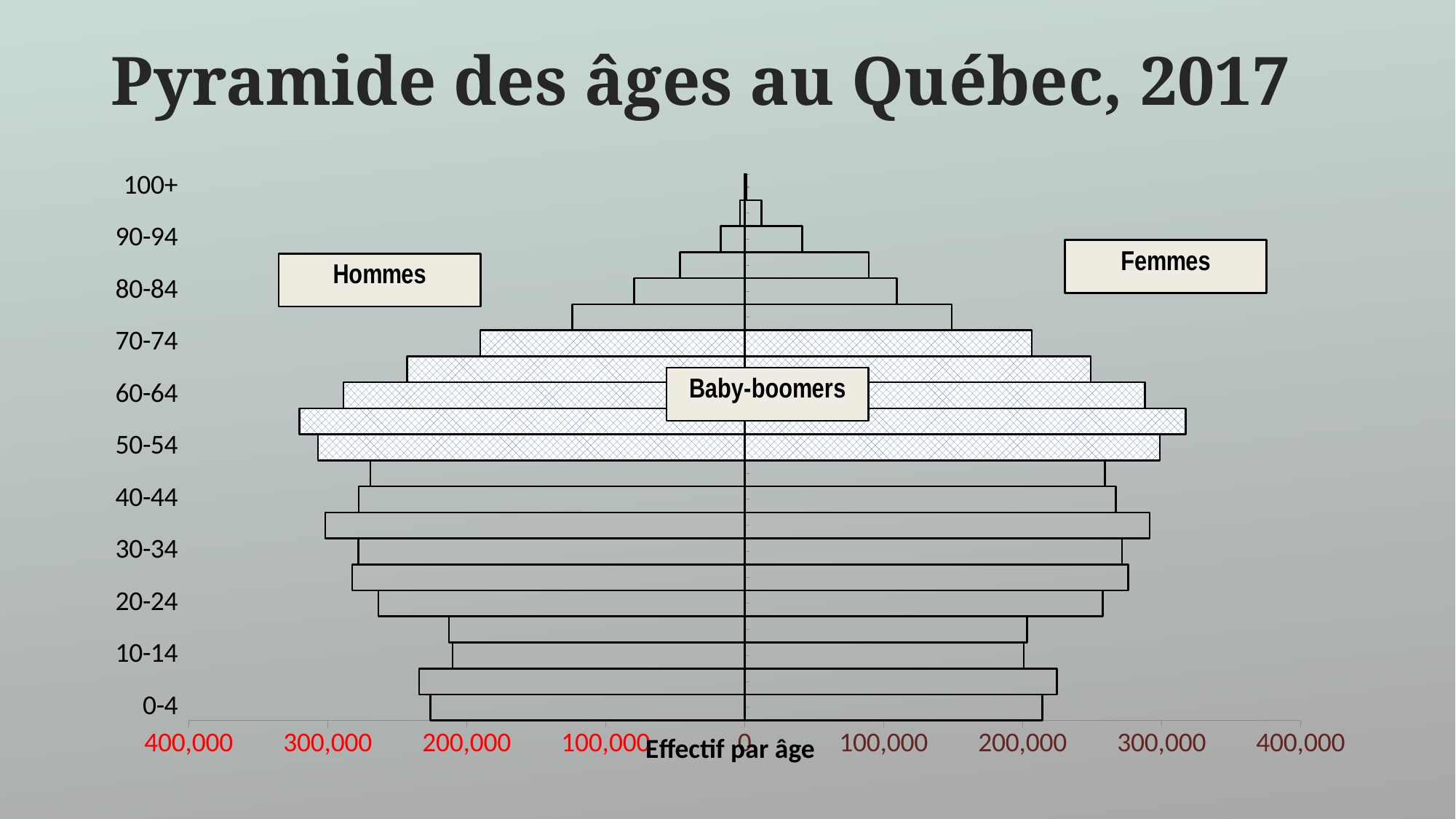
Which age group has the smallest population for both Hommes and Femmes? 100+ What is the title of the chart? Pyramide des âges au Québec, 2017 Which side of the chart shows the Hommes (men)? left How many population groups (sides) does the chart show, according to the labels Hommes and Femmes? 2 Do the bars get longer or shorter as the age groups go from 70-74 up to 100+? shorter Which is larger for Hommes: the 0-4 age group or the 80-84 age group? 0-4 Is the Hommes value for the 0-4 age group greater or less than 200,000? greater Which is larger for Femmes: the 90-94 age group or the 100+ age group? 90-94 Is the Femmes value for the 90-94 age group greater or less than 100,000? less What type of chart is shown on the slide? bar chart Is the Hommes value for the 20-24 age group greater or less than 300,000? less